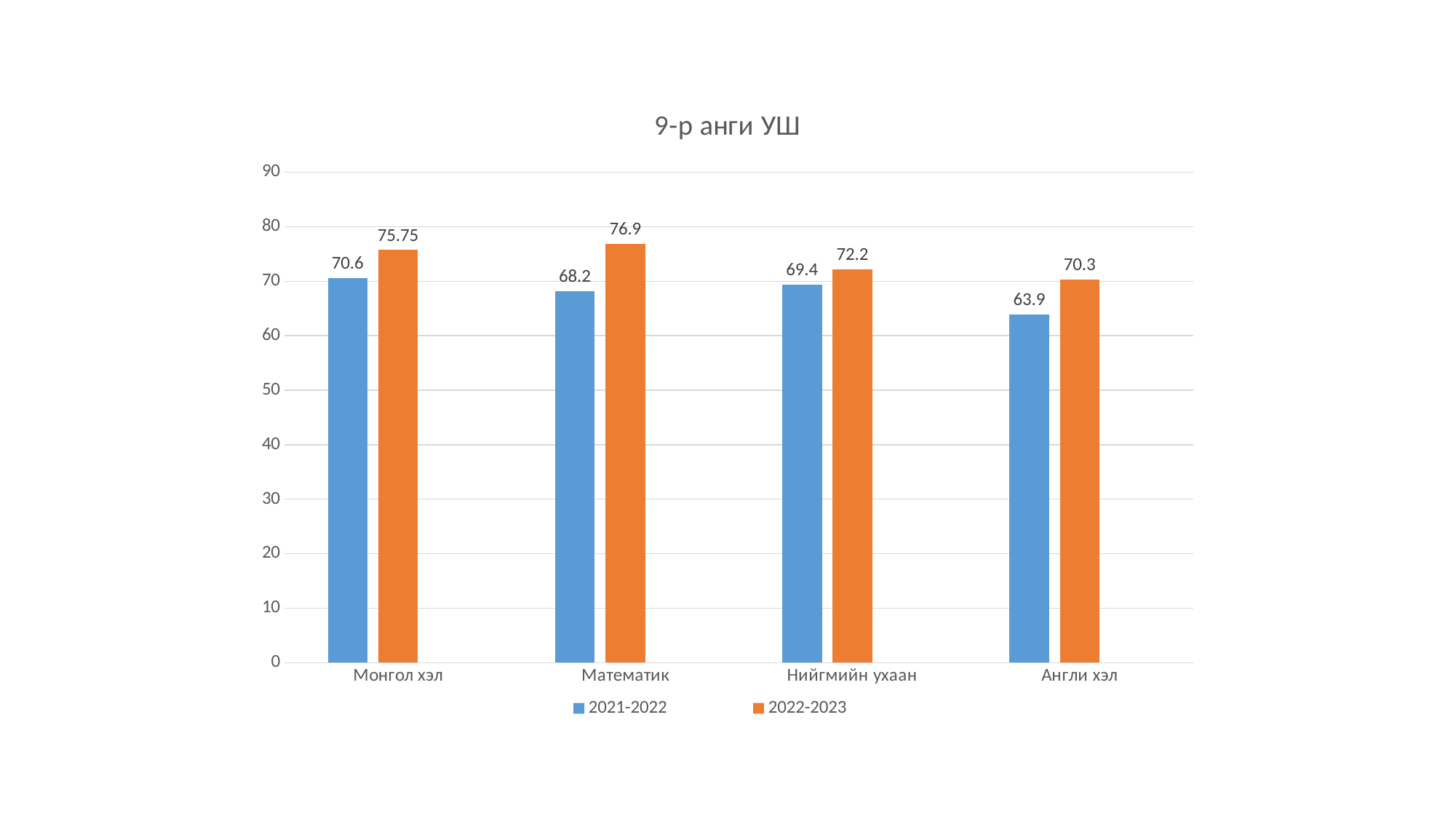
What is the value for Монгол хэл in the 2022-2023 series? 75.75 What is the value for Математик in the 2022-2023 series? 76.9 How many series does the legend list? 2 Which category has the lowest value in the 2021-2022 series? Англи хэл Is the 2021-2022 value for Математик greater or less than 70? less What is the difference between the 2022-2023 and 2021-2022 values for Англи хэл? 6.4 What kind of chart is shown on the slide? bar chart Which category has the highest value in the 2022-2023 series? Математик What is the value for Англи хэл in the 2021-2022 series? 63.9 How many categories are shown on the x axis? 4 What is the title of the chart? 9-р анги УШ Which is larger for Нийгмийн ухаан: the 2021-2022 value or the 2022-2023 value? 2022-2023